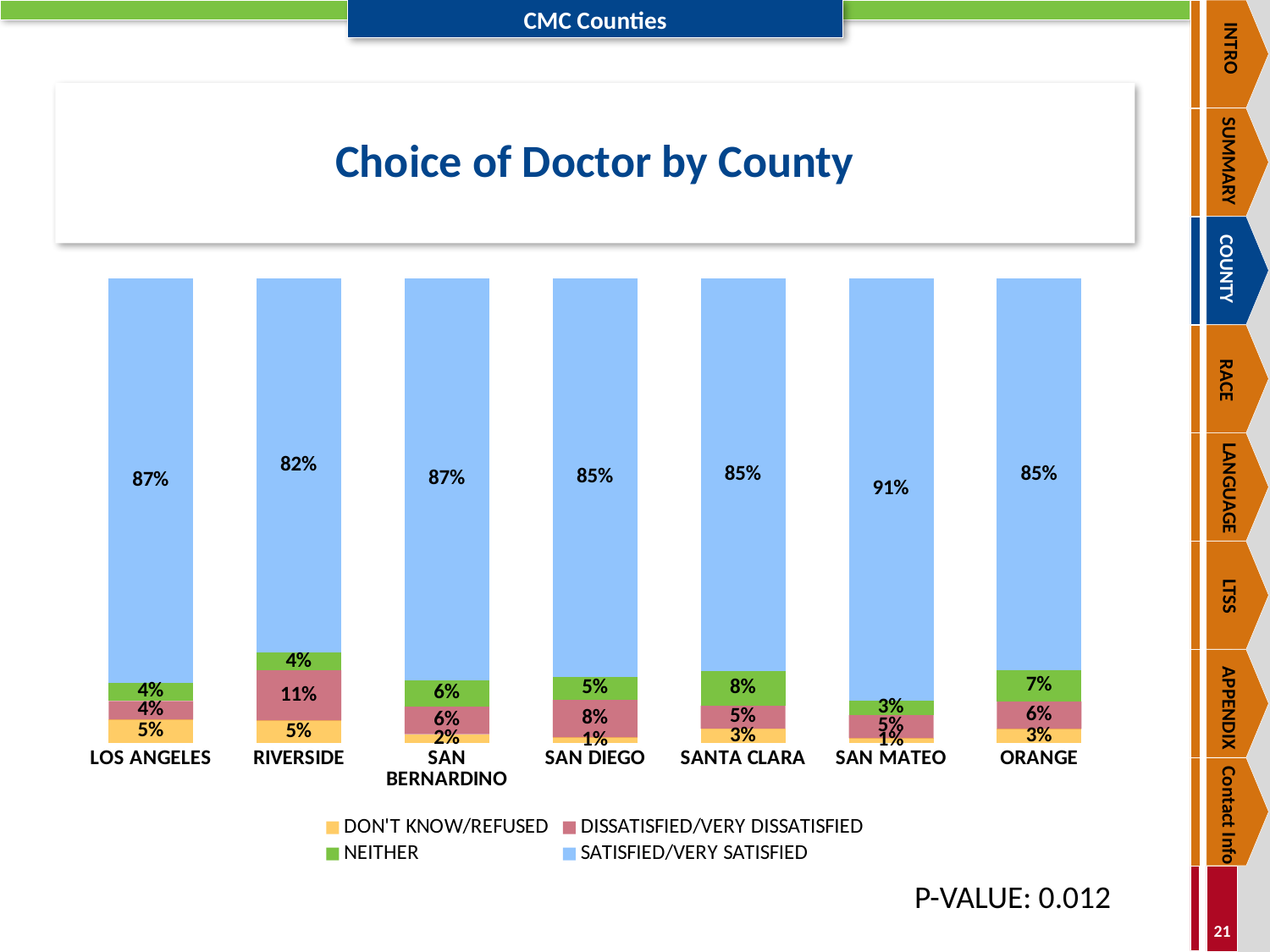
How many counties are shown in the chart? 7 What is the Neither percentage for Santa Clara? 8% Which county has a larger Dissatisfied/Very Dissatisfied percentage, San Diego or Los Angeles? San Diego What p-value is shown below the chart? 0.012 What type of chart is shown on the slide? Stacked bar chart Which county has the highest Satisfied/Very Satisfied percentage? San Mateo Which county has the lowest Satisfied/Very Satisfied percentage? Riverside What is the Don't Know/Refused percentage for San Bernardino? 2% What percentage of respondents in Riverside were Dissatisfied/Very Dissatisfied? 11% What is the difference between the Satisfied/Very Satisfied percentages for San Mateo and Riverside? 9% How many series does the legend list? 4 What percentage of respondents in San Mateo were Satisfied/Very Satisfied with their choice of doctor? 91%